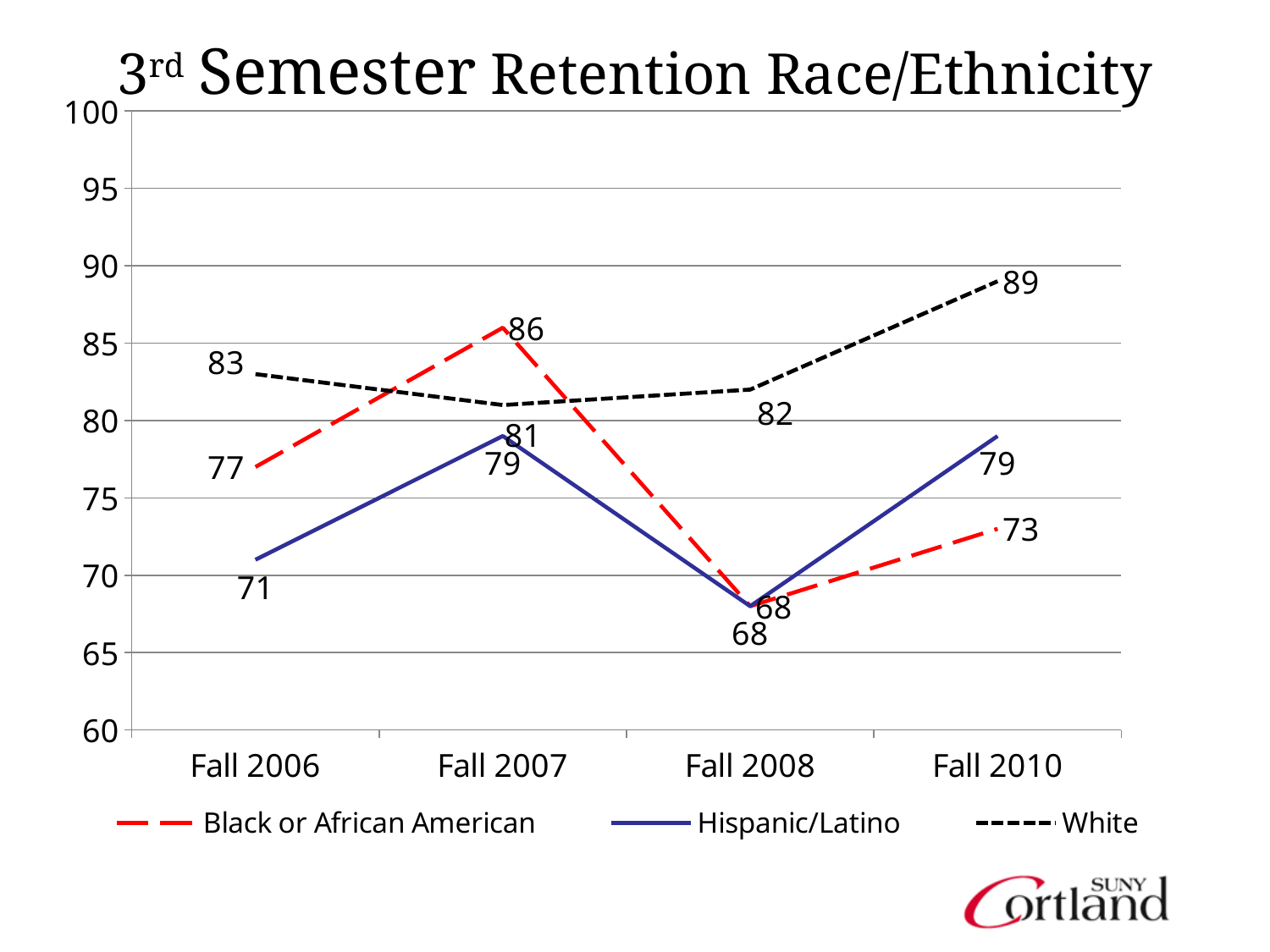
What is the difference between the White value and the Black or African American value in Fall 2010? 16 What is the title of the chart? 3rd Semester Retention Race/Ethnicity How many semesters are plotted along the x axis? 4 What is the value for Hispanic/Latino in Fall 2006? 71 How many series does the legend list? 3 In which semester is the White series lowest? Fall 2007 In which semester is the Black or African American series highest? Fall 2007 What is the value for Black or African American in Fall 2007? 86 What is the value for White in Fall 2010? 89 What type of chart is shown on the slide? line chart Does the White series rise or fall from Fall 2008 to Fall 2010? rise Which series has the larger value in Fall 2007, Black or African American or White? Black or African American